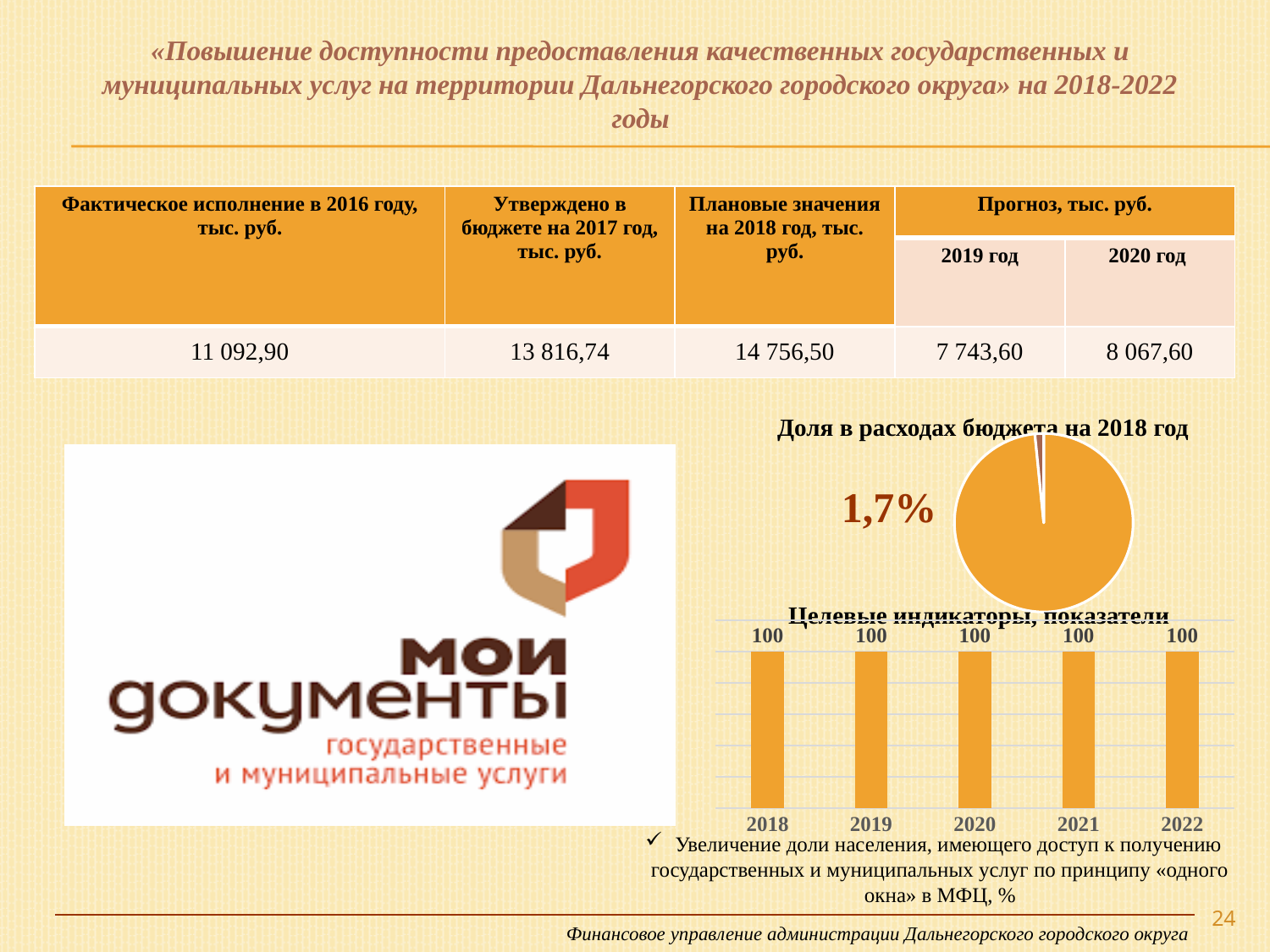
In the chart «Целевые индикаторы, показатели», what is the value for 2018? 100 How many bars are shown in the chart «Целевые индикаторы, показатели»? 5 In the chart «Целевые индикаторы, показатели», what is the value for 2022? 100 What kind of chart is the chart titled «Доля в расходах бюджета на 2018 год»? pie chart In the pie chart «Доля в расходах бюджета на 2018 год», what share is shown for the small slice? 1,7% In the chart «Целевые индикаторы, показатели», do the values rise, fall or stay the same from 2018 to 2022? stay the same What is the first year shown on the x axis of the chart «Целевые индикаторы, показатели»? 2018 In the chart «Целевые индикаторы, показатели», what is the difference between the values for 2021 and 2019? 0 What kind of chart is the chart titled «Целевые индикаторы, показатели»? bar chart In the pie chart «Доля в расходах бюджета на 2018 год», is the labelled slice the larger or the smaller of the two slices? smaller In the chart «Целевые индикаторы, показатели», what is the value for 2020? 100 What is the title of the bar chart on the slide? Целевые индикаторы, показатели